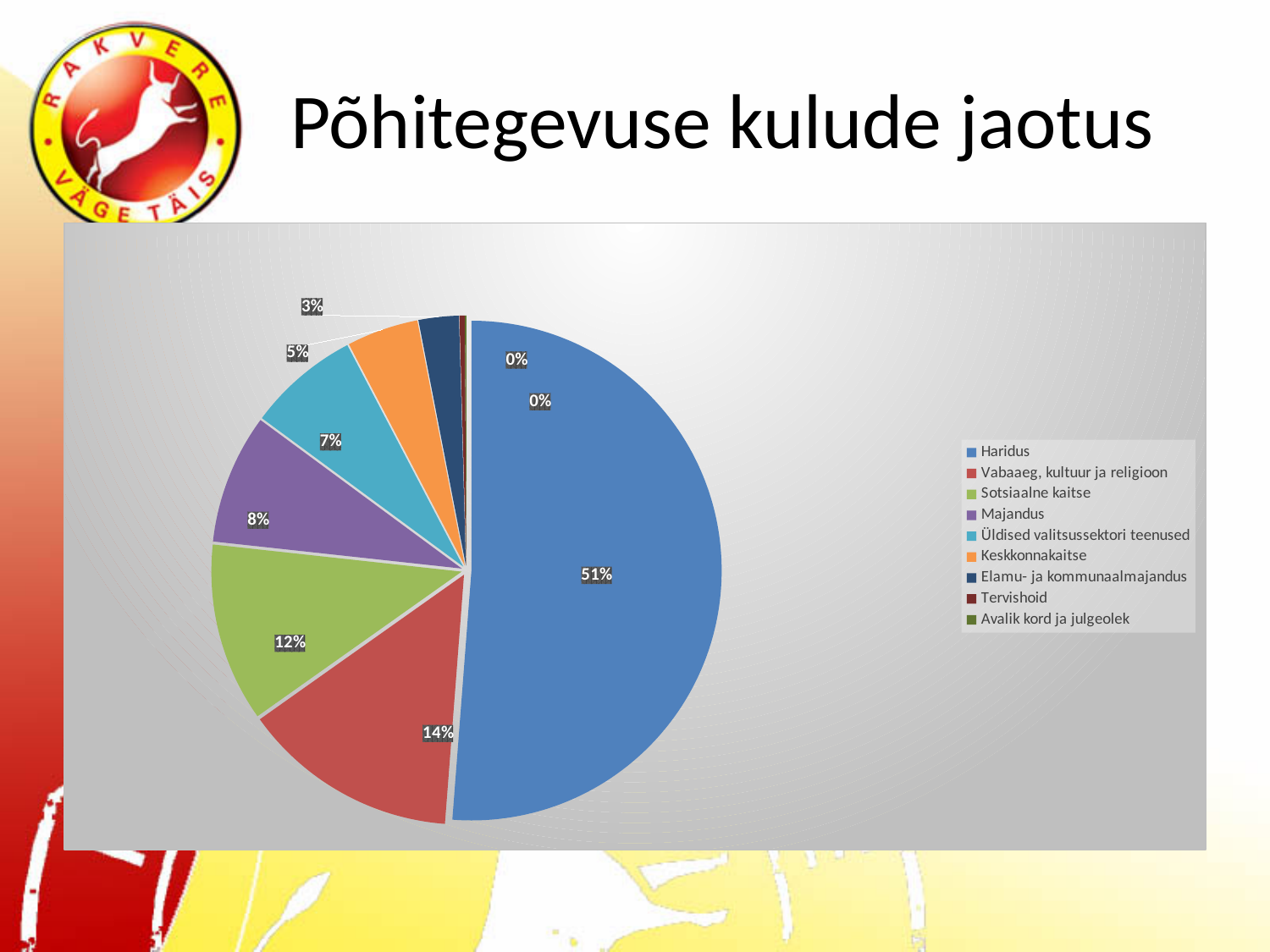
Which category has the largest share of the pie? Haridus Which has a larger share, Majandus or Üldised valitsussektori teenused? Majandus What type of chart is shown on the slide? Pie chart What percentage is shown for Elamu- ja kommunaalmajandus? 3% What percentage is shown for Sotsiaalne kaitse? 12% What percentage is shown for Majandus? 8% What is the difference in percentage points between Haridus and Vabaaeg, kultuur ja religioon? 37 What is the title of the chart? Põhitegevuse kulude jaotus How many categories does the legend list? 9 What percentage is shown for Keskkonnakaitse? 5% What share of the pie does Haridus take? 51% What percentage is shown for Vabaaeg, kultuur ja religioon? 14%